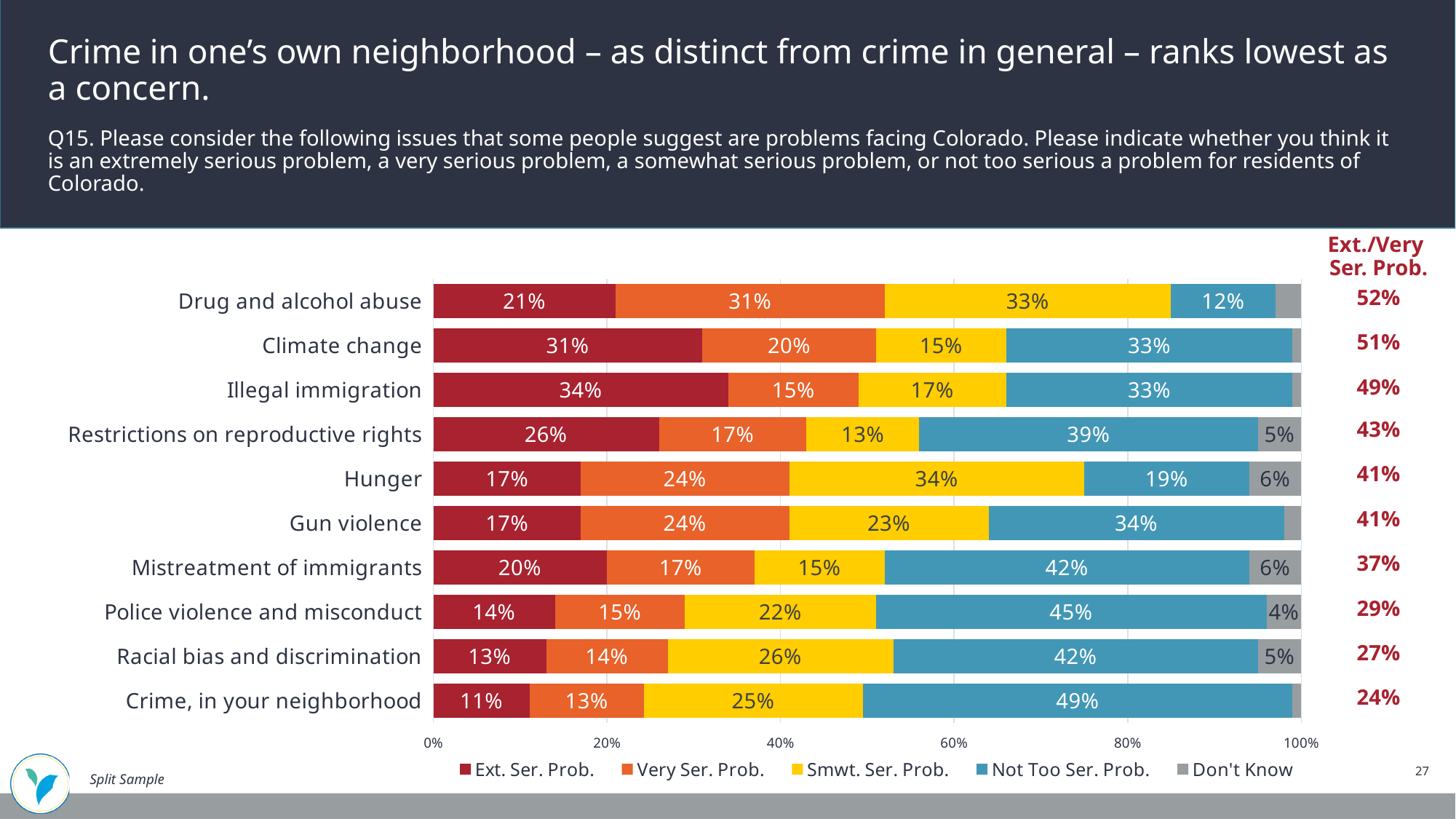
Which issue has the lowest Ext. Ser. Prob. value? Crime, in your neighborhood What is the Smwt. Ser. Prob. value for Hunger? 34% Which has a larger Not Too Ser. Prob. value: Police violence and misconduct or Mistreatment of immigrants? Police violence and misconduct What is the combined Ext./Very Ser. Prob. figure shown for Gun violence? 41% Which issue has the highest Not Too Ser. Prob. value? Crime, in your neighborhood What percentage of respondents rated illegal immigration as an extremely serious problem (Ext. Ser. Prob.)? 34% How many issues are listed on the chart? 10 Which issue has the highest Ext. Ser. Prob. value? Illegal immigration What is the Not Too Ser. Prob. value for 'Crime, in your neighborhood'? 49% How many series does the legend list? 5 What is the difference between the Very Ser. Prob. values for Drug and alcohol abuse and Climate change? 11 percentage points What kind of chart is shown on the slide? Stacked bar chart